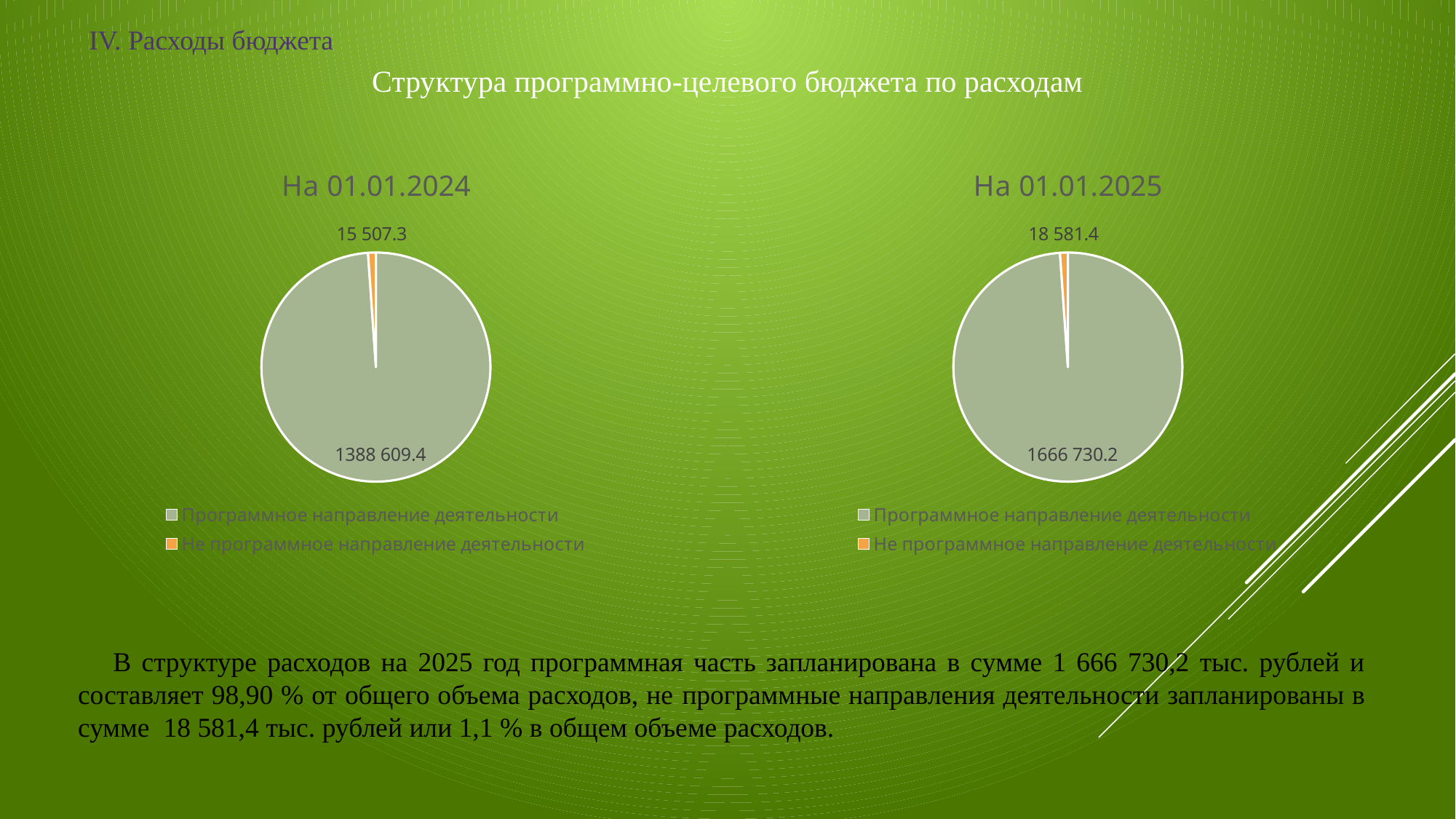
Which is larger: the value for Не программное направление деятельности in the chart titled "На 01.01.2024" or in the chart titled "На 01.01.2025"? На 01.01.2025 In the chart titled "На 01.01.2025", what is the value for Программное направление деятельности? 1666 730.2 In the chart titled "На 01.01.2025", which category has the largest slice? Программное направление деятельности In the chart titled "На 01.01.2024", what is the value for Не программное направление деятельности? 15 507.3 In the chart titled "На 01.01.2025", what is the value for Не программное направление деятельности? 18 581.4 What colour is the slice for Не программное направление деятельности in the chart titled "На 01.01.2024"? Orange What kind of chart is the chart titled "На 01.01.2024"? Pie chart In the chart titled "На 01.01.2024", what is the value for Программное направление деятельности? 1388 609.4 In the chart titled "На 01.01.2024", which category has the smallest slice? Не программное направление деятельности How many categories does the chart titled "На 01.01.2025" show? 2 What is the difference between the value for Не программное направление деятельности in the chart titled "На 01.01.2025" and in the chart titled "На 01.01.2024"? 3 074.1 What is the difference between the value for Программное направление деятельности in the chart titled "На 01.01.2025" and in the chart titled "На 01.01.2024"? 278 120.8